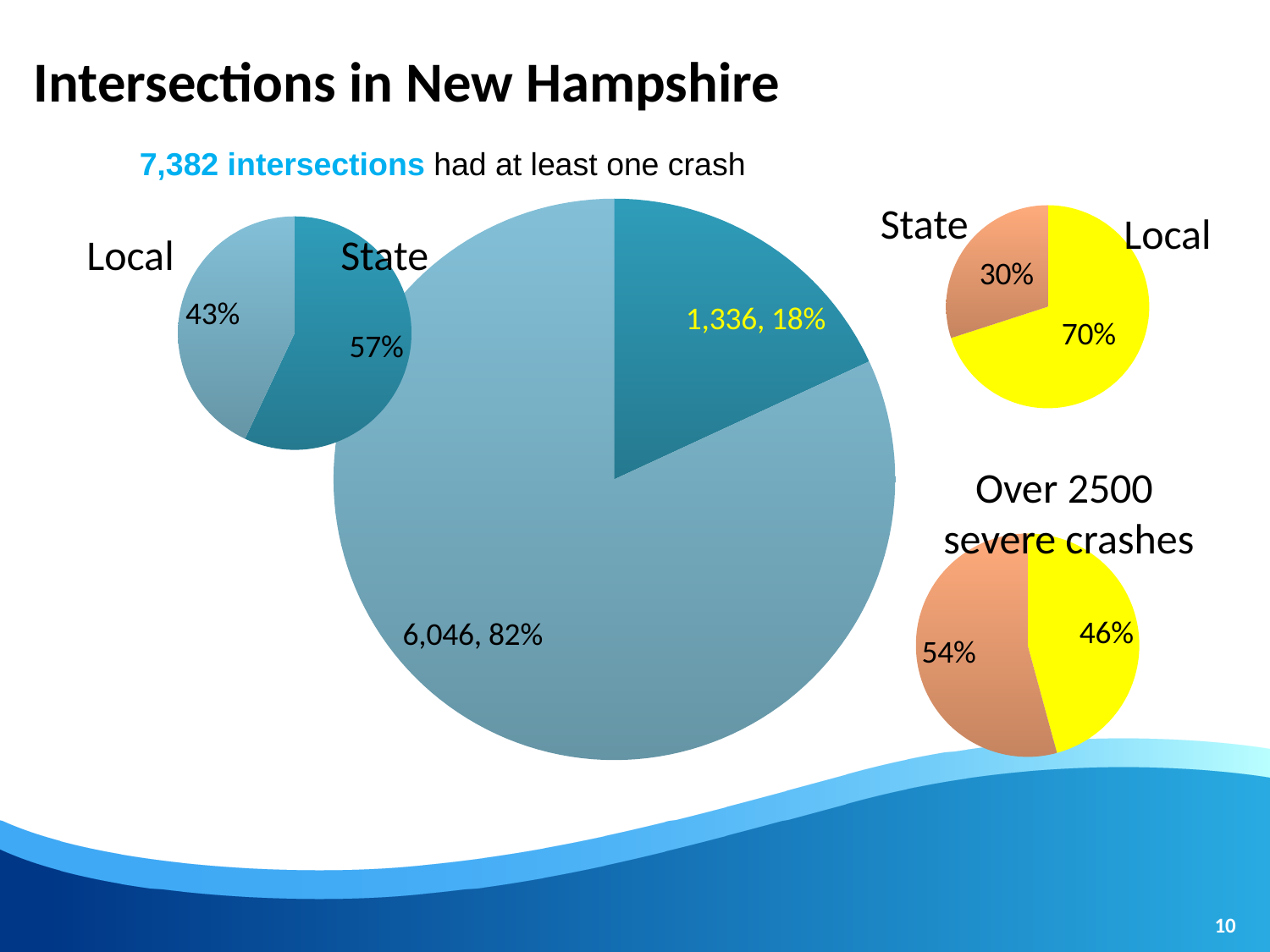
In the small pie chart at the top left, which is larger, Local or State? State In the pie chart at the top right, what is the share for Local? 70% In the large central pie chart, what value is printed on the smaller slice? 1,336, 18% In the pie chart at the top right, what is the difference between the Local and State shares? 40% In the large central pie chart, what value is printed on the larger slice? 6,046, 82% What kind of charts are shown on the slide? Pie charts In the small pie chart at the top left, what is the share for State? 57% In the small pie chart at the top left, what is the share for Local? 43% In the large central pie chart, what share of the pie does the smaller slice represent? 18% In the large central pie chart, what is the difference between the two slice values, 6,046 and 1,336? 4,710 In the pie chart at the top right, what is the share for State? 30% In the 'Over 2500 severe crashes' pie chart at the bottom right, what is the share of the yellow slice? 46%